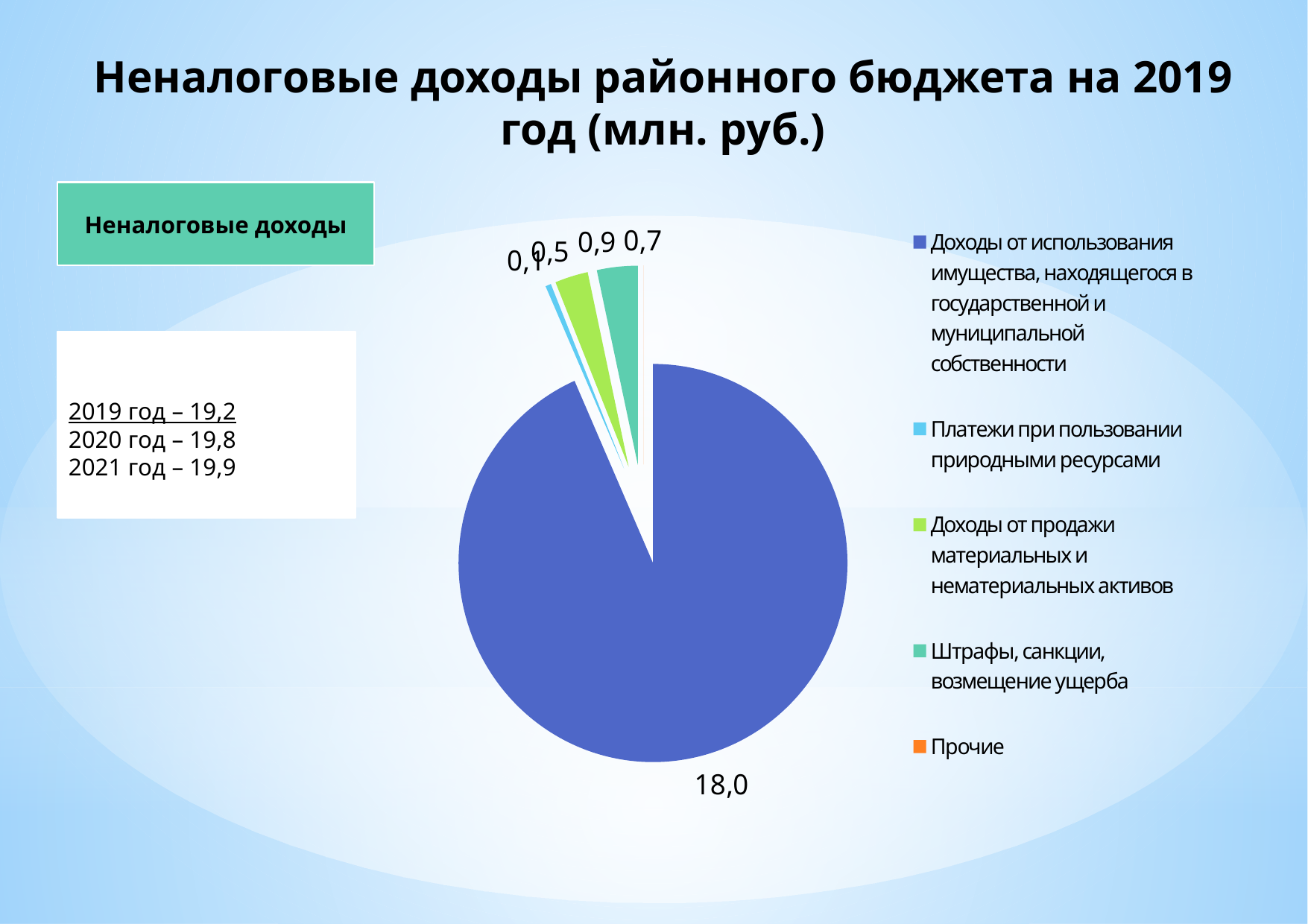
What is the title of the slide containing the pie chart? Неналоговые доходы районного бюджета на 2019 год (млн. руб.) What is the value for "Доходы от использования имущества, находящегося в государственной и муниципальной собственности" in the pie chart? 18,0 What kind of chart is shown on the slide? Pie chart How many categories does the legend of the pie chart list? 5 What is the value for "Платежи при пользовании природными ресурсами" in the pie chart? 0,1 Which category has the largest slice in the pie chart? Доходы от использования имущества, находящегося в государственной и муниципальной собственности Which is larger: the slice for "Доходы от использования имущества" or the slice for "Штрафы, санкции, возмещение ущерба"? Доходы от использования имущества What colour is the largest slice of the pie chart? Blue